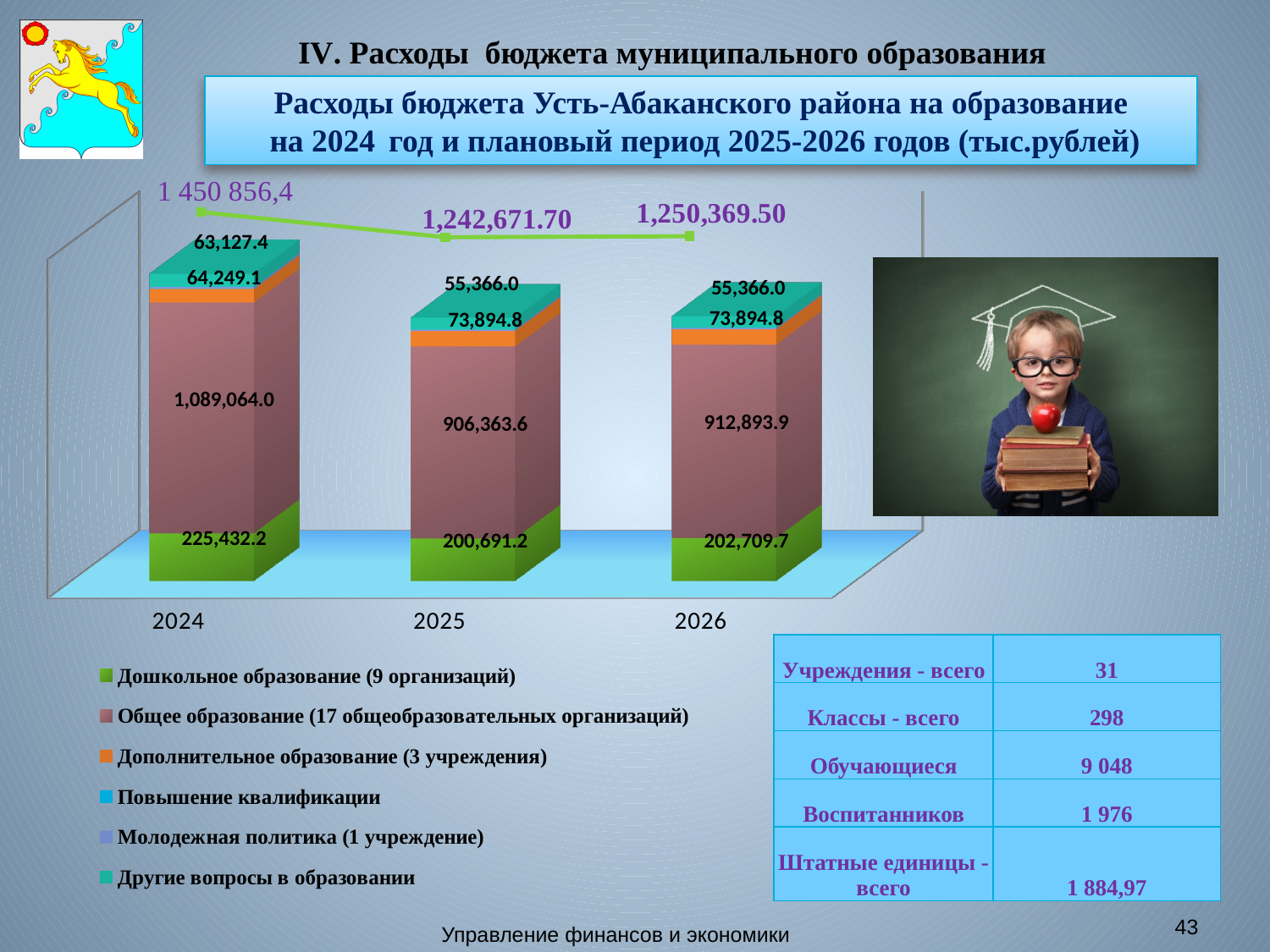
What type of chart is shown on the slide? stacked bar chart What is the value for Дошкольное образование in 2024? 225,432.2 What is the difference between the Дошкольное образование values for 2026 and 2025? 2,018.5 What is the value for Общее образование in 2026? 912,893.9 Which is larger: the Общее образование value for 2024 or for 2026? 2024 What is the total education expenditure shown for 2026? 1,250,369.50 In which year is the value for Общее образование the highest? 2024 In which year is the value for Дошкольное образование the lowest? 2025 What is the value for Общее образование in 2025? 906,363.6 What is the total education expenditure shown for 2024? 1 450 856,4 How many years (categories) are shown on the x axis of the chart? 3 How many series does the chart legend list? 6